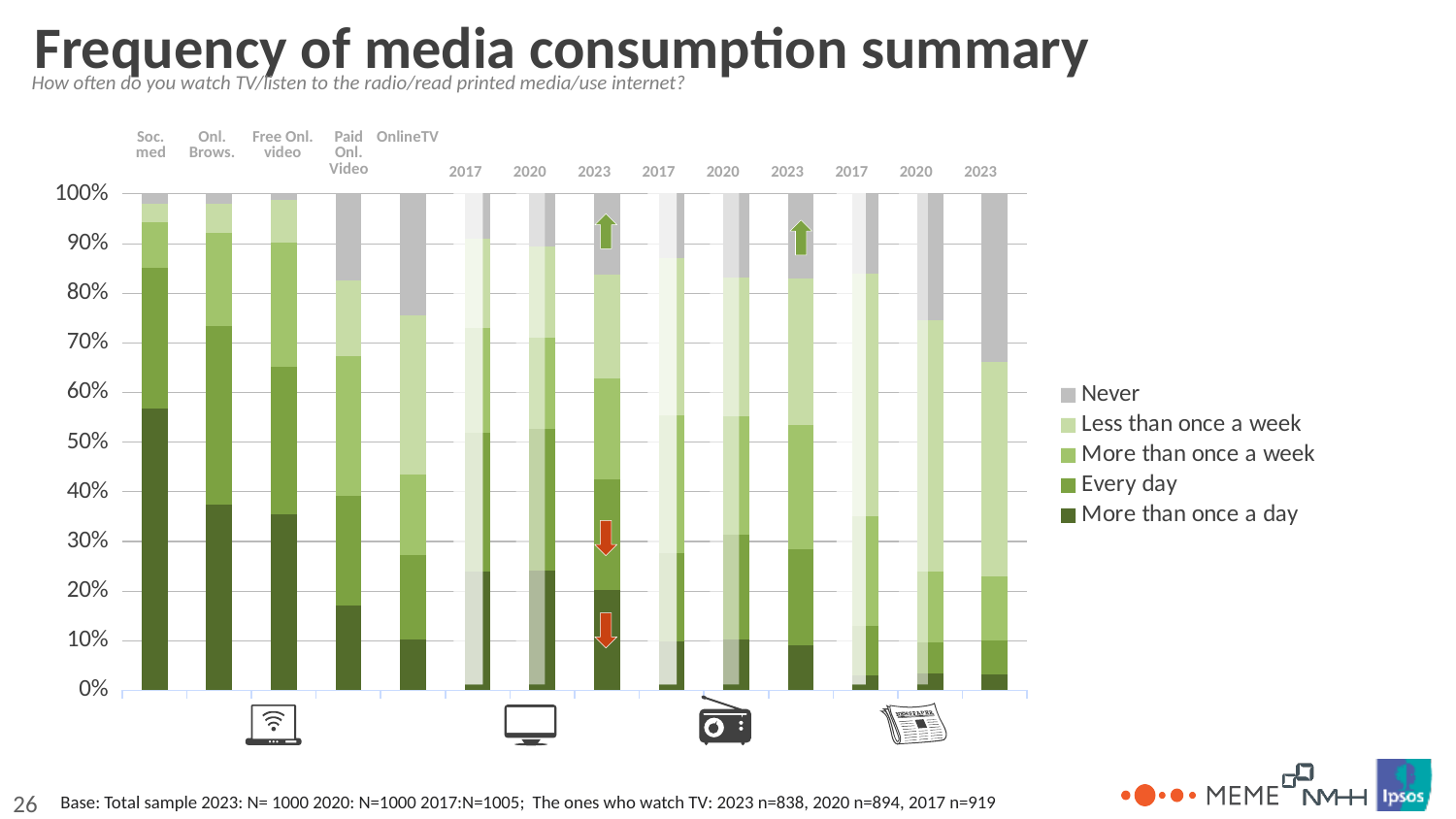
Which has the larger 'More than once a day' share: Soc. med or Onl. Brows.? Soc. med Is the 'More than once a day' share for Free Onl. video greater or less than 30%? greater Which legend entry is shown in the lightest grey colour? Never Which has the larger 'More than once a day' share: Soc. med or OnlineTV? Soc. med Which year labels are shown for the TV, radio and printed media groups? 2017, 2020, 2023 Is the 'Never' share for OnlineTV greater or less than 20%? greater How many series does the legend list? 5 Is the 'More than once a day' share for Soc. med greater or less than 50%? greater How many stacked bars are plotted in the chart? 14 What kind of chart is shown on the slide? Stacked bar chart What is the title of the chart slide? Frequency of media consumption summary